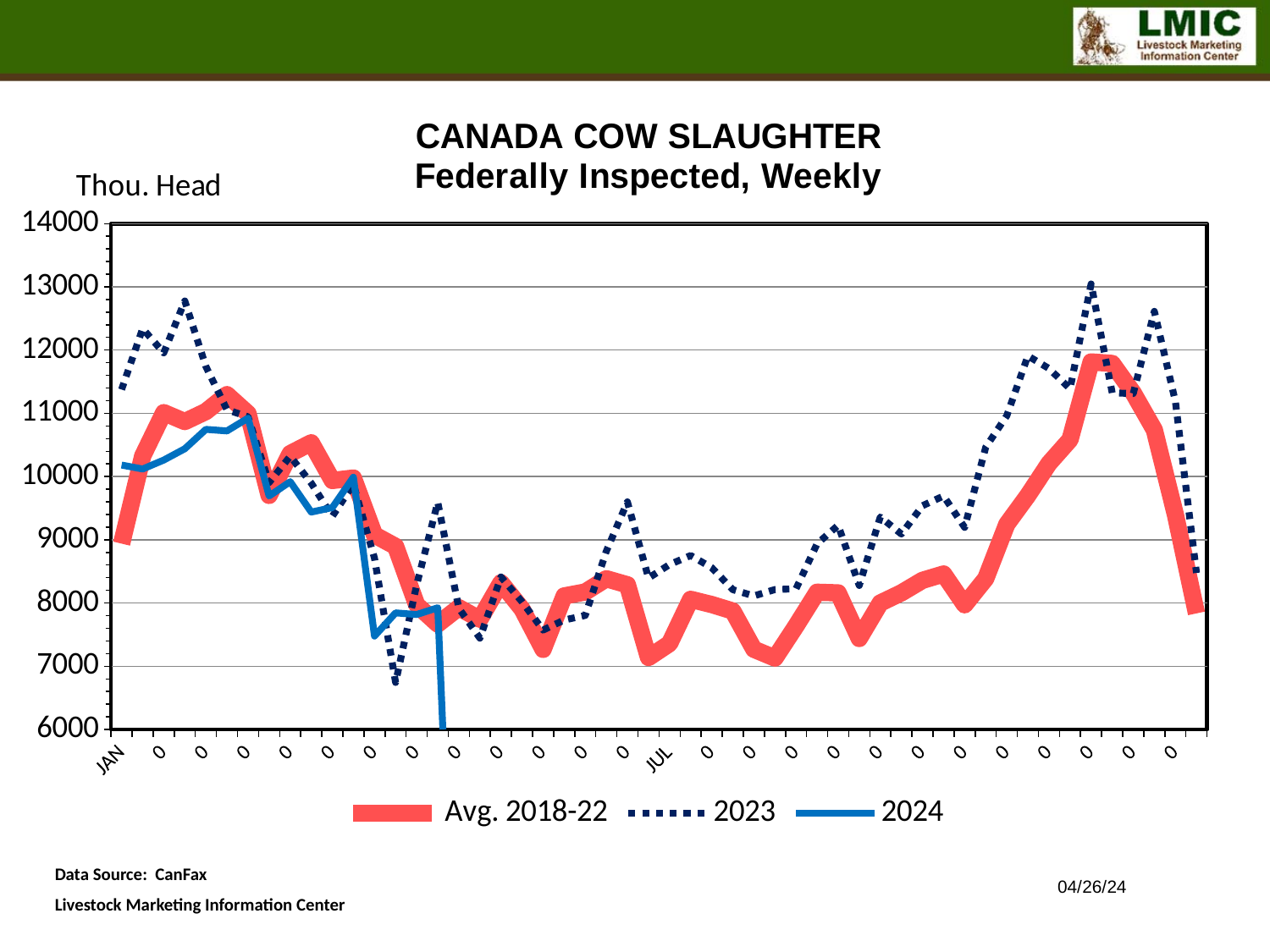
Is the value of the Avg. 2018-22 series at JAN greater or less than 10000? less Is the value of the 2024 series at JAN greater or less than 11000? less Is the highest value of the 2023 series greater or less than 12000? greater What are the three series named in the legend? Avg. 2018-22, 2023, 2024 Does the Avg. 2018-22 series generally rise or fall from JAN to JUL? fall What kind of chart is shown on the slide? line chart What unit label is shown above the y axis? Thou. Head How many series does the legend list? 3 Which series reaches the highest peak on the chart? 2023 At JAN, which series has the higher value, 2023 or Avg. 2018-22? 2023